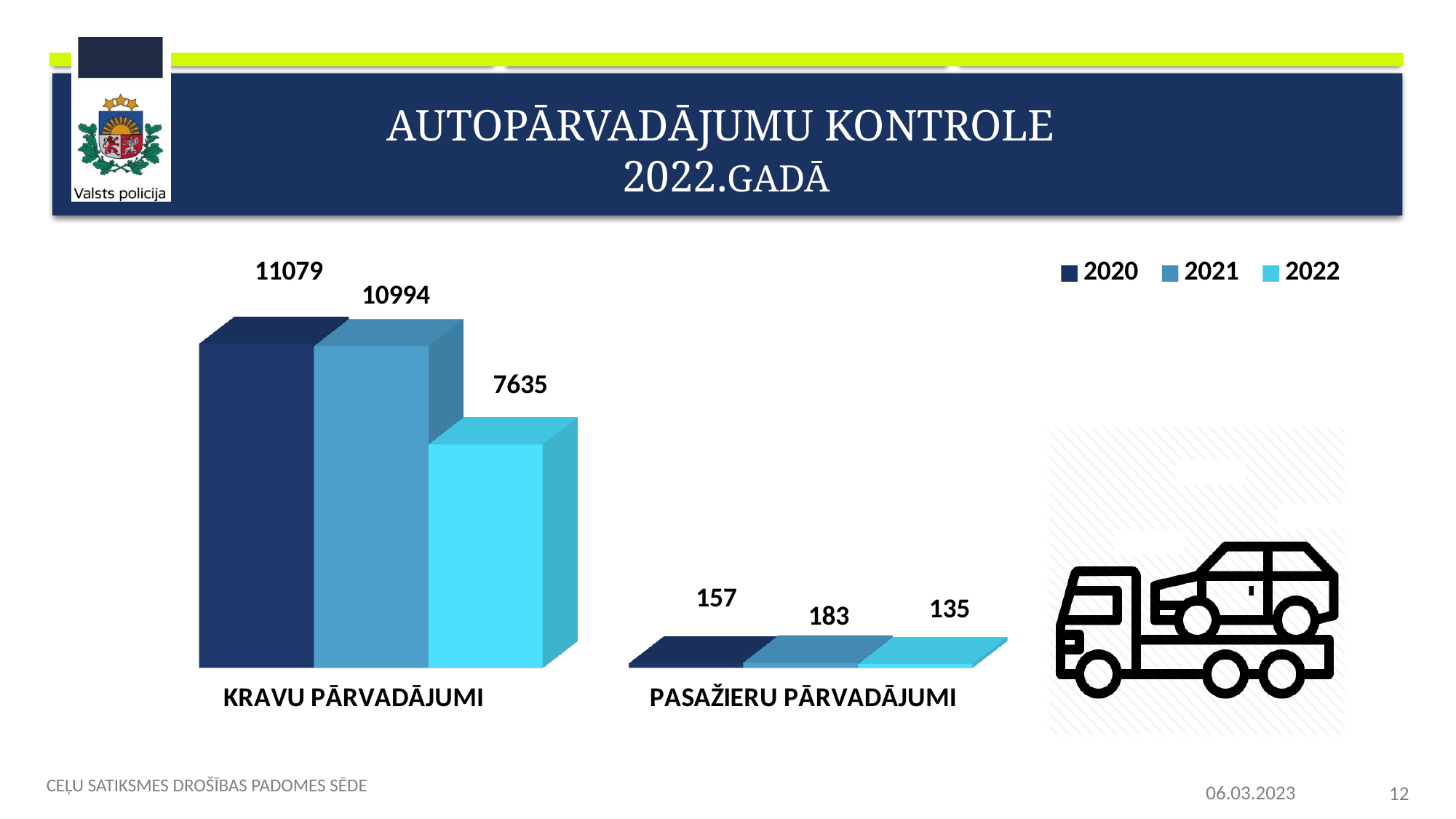
How many series does the legend list? 3 What is the value for 2022 in the PASAŽIERU PĀRVADĀJUMI category? 135 What is the difference between the 2020 and 2022 values for KRAVU PĀRVADĀJUMI? 3444 What is the value for 2020 in the KRAVU PĀRVADĀJUMI category? 11079 Which year has the highest value in the KRAVU PĀRVADĀJUMI category? 2020 Which is larger for PASAŽIERU PĀRVADĀJUMI: the 2020 value or the 2021 value? 2021 Which year has the lowest value in the PASAŽIERU PĀRVADĀJUMI category? 2022 What kind of chart is shown on the slide? Bar chart How many categories are shown on the x axis of the chart? 2 What is the difference between the 2021 and 2020 values for PASAŽIERU PĀRVADĀJUMI? 26 What is the value for 2021 in the PASAŽIERU PĀRVADĀJUMI category? 183 What is the value for 2022 in the KRAVU PĀRVADĀJUMI category? 7635